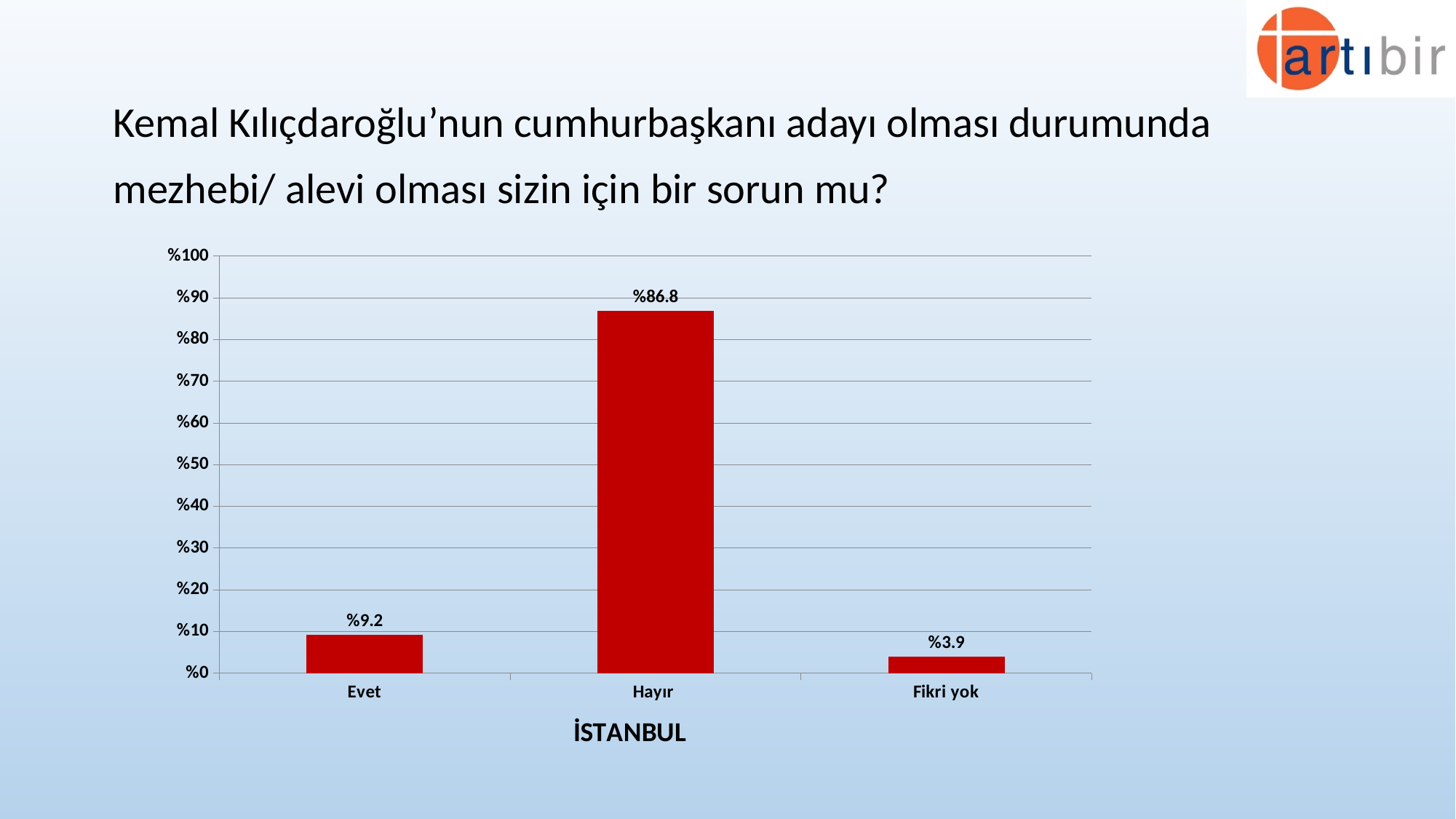
Which is larger, the value for Evet or the value for Fikri yok? Evet Which category has the highest value? Hayır What is the difference between the values for Hayır and Evet? %77.6 What kind of chart is shown on the slide? bar chart What is the value for Fikri yok? %3.9 Is the value for Hayır greater or less than %80? greater Which category has the lowest value? Fikri yok What is the value for Evet? %9.2 How many categories are shown on the x axis? 3 What label appears below the x axis of the chart? İSTANBUL What is the difference between the values for Evet and Fikri yok? %5.3 What is the value for Hayır? %86.8